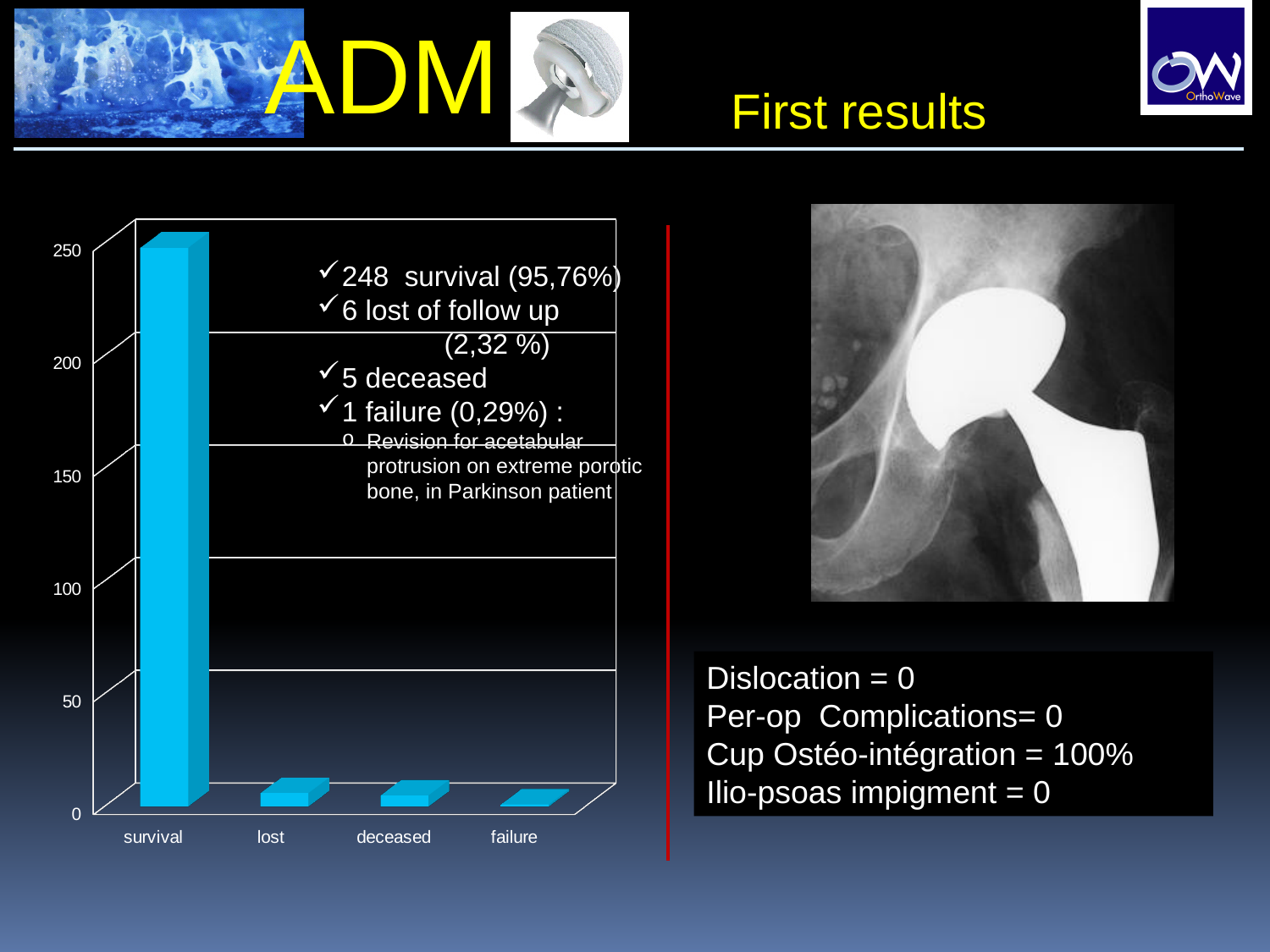
Which category has the shortest bar in the chart? failure What kind of chart is shown on the left of the slide? bar chart Which category has the tallest bar in the chart? survival Is the value for lost greater or less than 50? less What is the highest value labelled on the y axis of the chart? 250 Is the value for deceased greater or less than 100? less Is the value for survival greater or less than 200? greater Which is larger, the bar for lost or the bar for failure? lost According to the text on the chart, how many patients are in the survival category? 248 How many categories are shown on the x axis of the bar chart? 4 Which is larger, the bar for survival or the bar for deceased? survival Do the bar values rise or fall moving from left to right along the x axis? fall